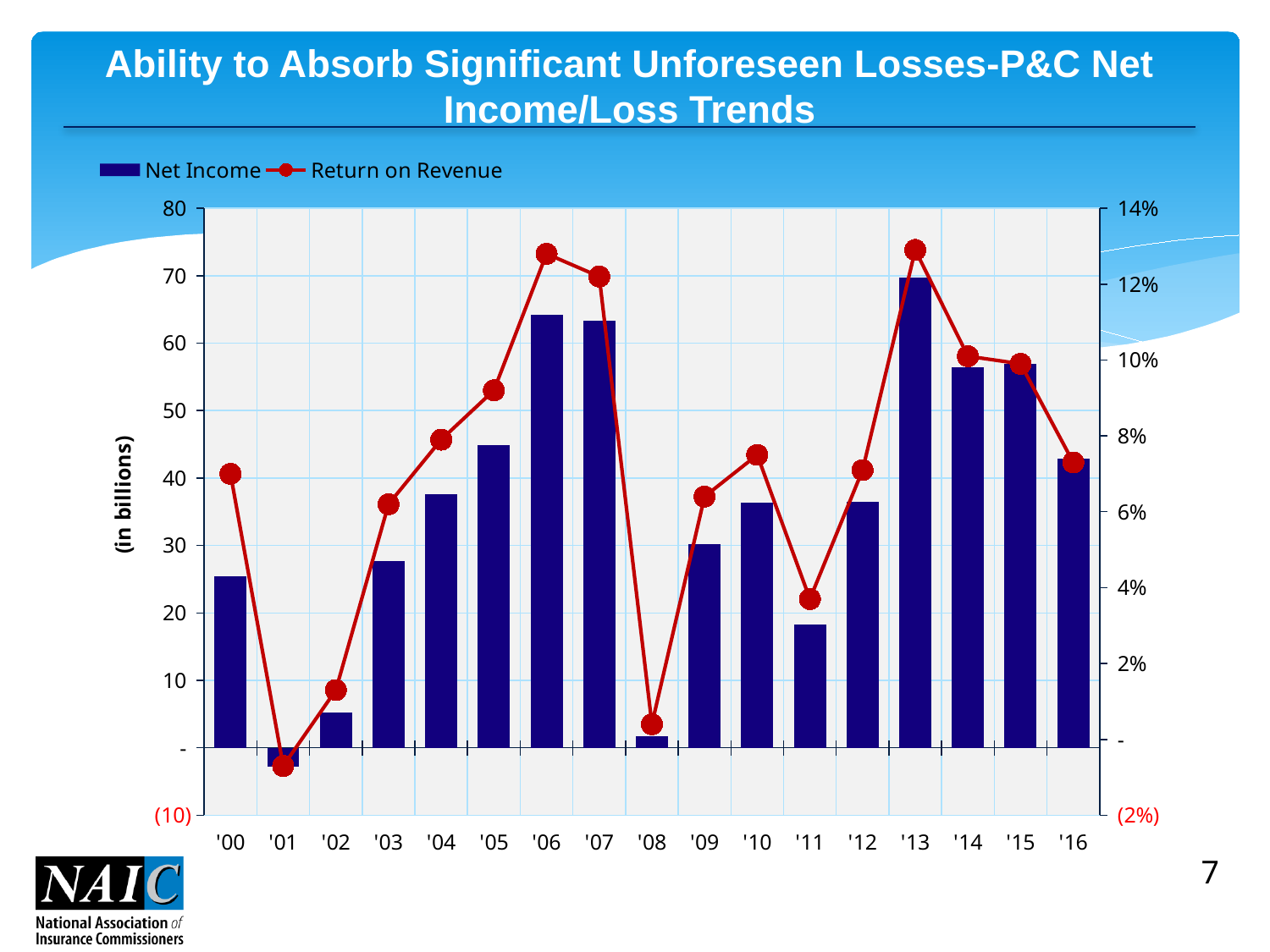
Which year has the lowest Net Income? '01 How many series does the legend list? 2 Is the Net Income value for '11 greater or less than 20? less Which year has the larger Net Income, '09 or '10? '10 Is the Net Income value for '06 greater or less than 60? greater Is the Return on Revenue value for '05 greater or less than 8%? greater Which year has the lowest Return on Revenue? '01 What kind of chart is this? Combined bar and line chart Does Net Income rise or fall from '13 to '16? fall Which year has the highest Net Income? '13 How many years are shown on the x axis? 17